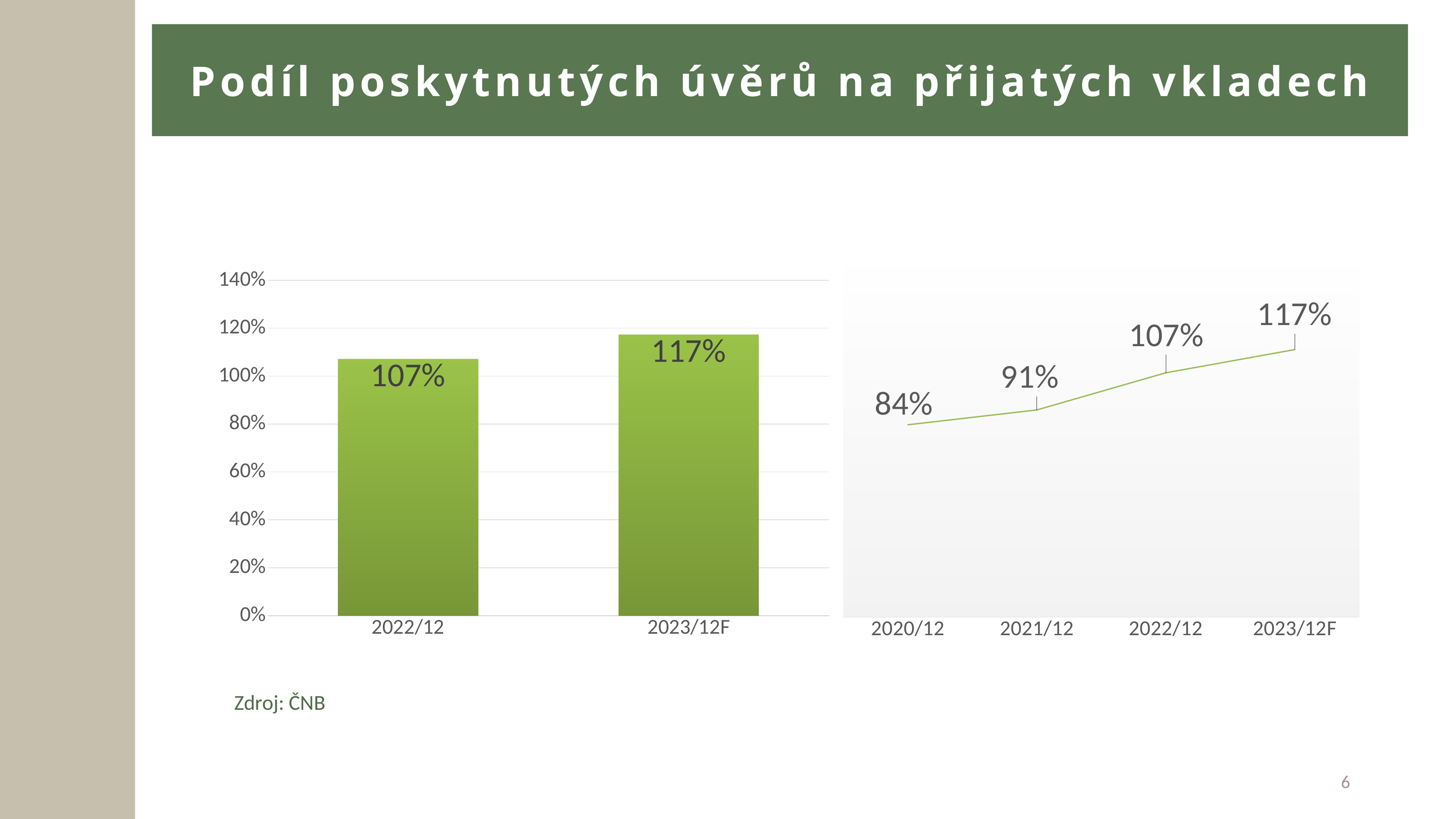
In the line chart on the right, what is the value for 2020/12? 84% In the bar chart on the left, what is the value for 2023/12F? 117% In the bar chart on the left, what is the difference between the 2023/12F and 2022/12 values? 10% In the line chart on the right, what is the difference between the 2022/12 and 2021/12 values? 16% In the bar chart on the left, what is the value for 2022/12? 107% In the line chart on the right, what is the value for 2021/12? 91% In the line chart on the right, which period has the lowest value? 2020/12 In the line chart on the right, which period has the highest value? 2023/12F What kind of chart is the chart on the left? bar chart In the bar chart on the left, how many bars are plotted? 2 In the line chart on the right, how many data points are plotted? 4 In the line chart on the right, do the values rise or fall from 2020/12 to 2023/12F? rise